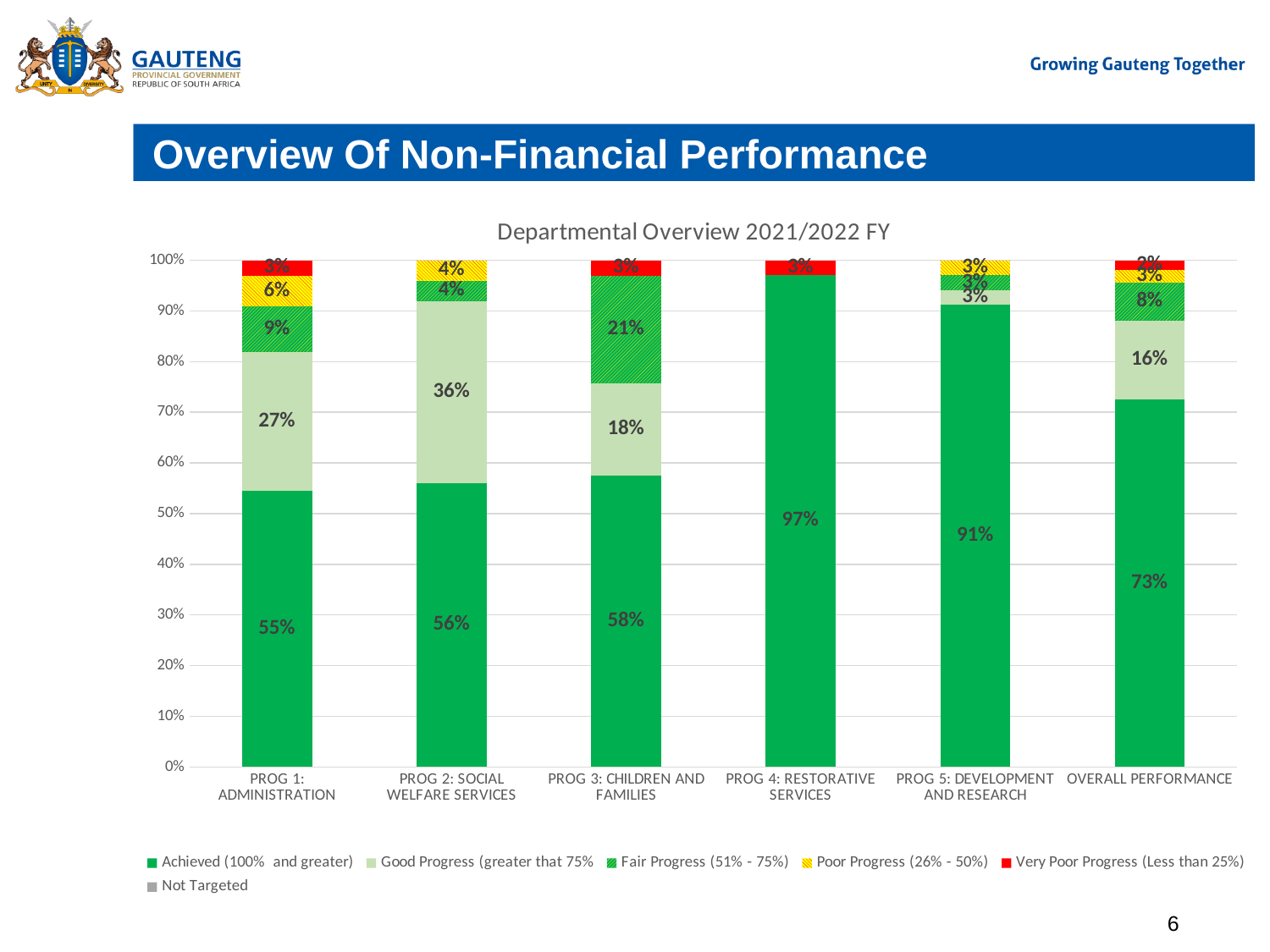
What kind of chart is shown on the slide? Stacked bar chart Which has the larger Good Progress value, PROG 1: ADMINISTRATION or PROG 3: CHILDREN AND FAMILIES? PROG 1: ADMINISTRATION What is the Good Progress value for PROG 2: SOCIAL WELFARE SERVICES? 36% What is the Achieved (100% and greater) value for PROG 4: RESTORATIVE SERVICES? 97% How many programme categories are shown along the x axis? 6 What is the difference between the Achieved values for PROG 4: RESTORATIVE SERVICES and PROG 5: DEVELOPMENT AND RESEARCH? 6 percentage points Which category has the highest Achieved (100% and greater) value? PROG 4: RESTORATIVE SERVICES What is the Fair Progress value for PROG 3: CHILDREN AND FAMILIES? 21% Which category has the lowest Achieved (100% and greater) value? PROG 1: ADMINISTRATION What is the title of the chart? Departmental Overview 2021/2022 FY What is the Achieved value for OVERALL PERFORMANCE? 73% How many series does the legend list? 6